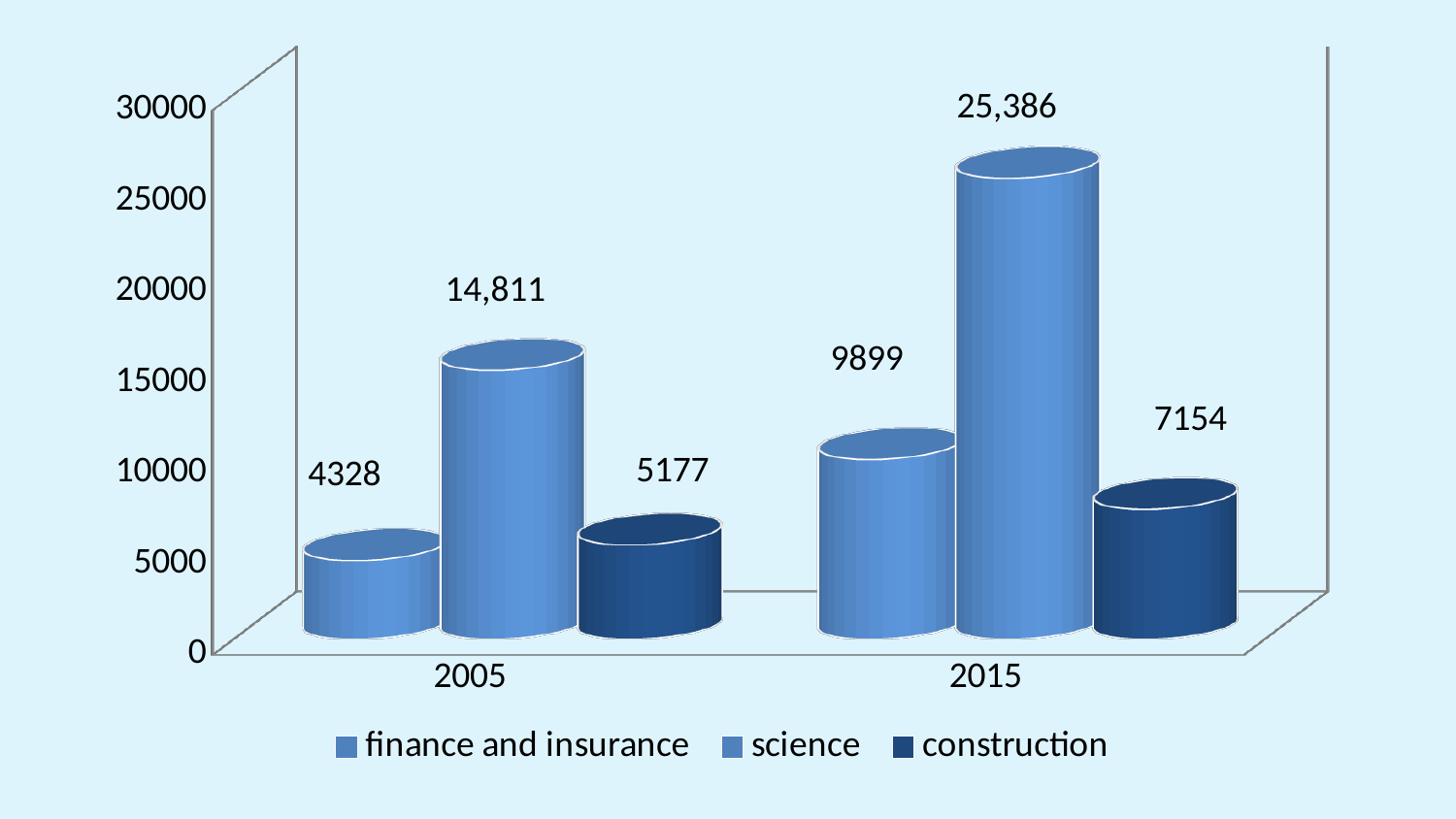
How many categories are shown on the x axis? 2 Which is larger in 2015: finance and insurance or construction? finance and insurance Which series has the highest value in 2015? science What kind of chart is this? bar chart What is the value for finance and insurance in 2015? 9899 How many series does the legend list? 3 What is the value for science in 2005? 14,811 What is the value for construction in 2005? 5177 Does the value for construction rise or fall from 2005 to 2015? rise What is the difference between the science values for 2015 and 2005? 10,575 Which series has the lowest value in 2005? finance and insurance What is the value for science in 2015? 25,386